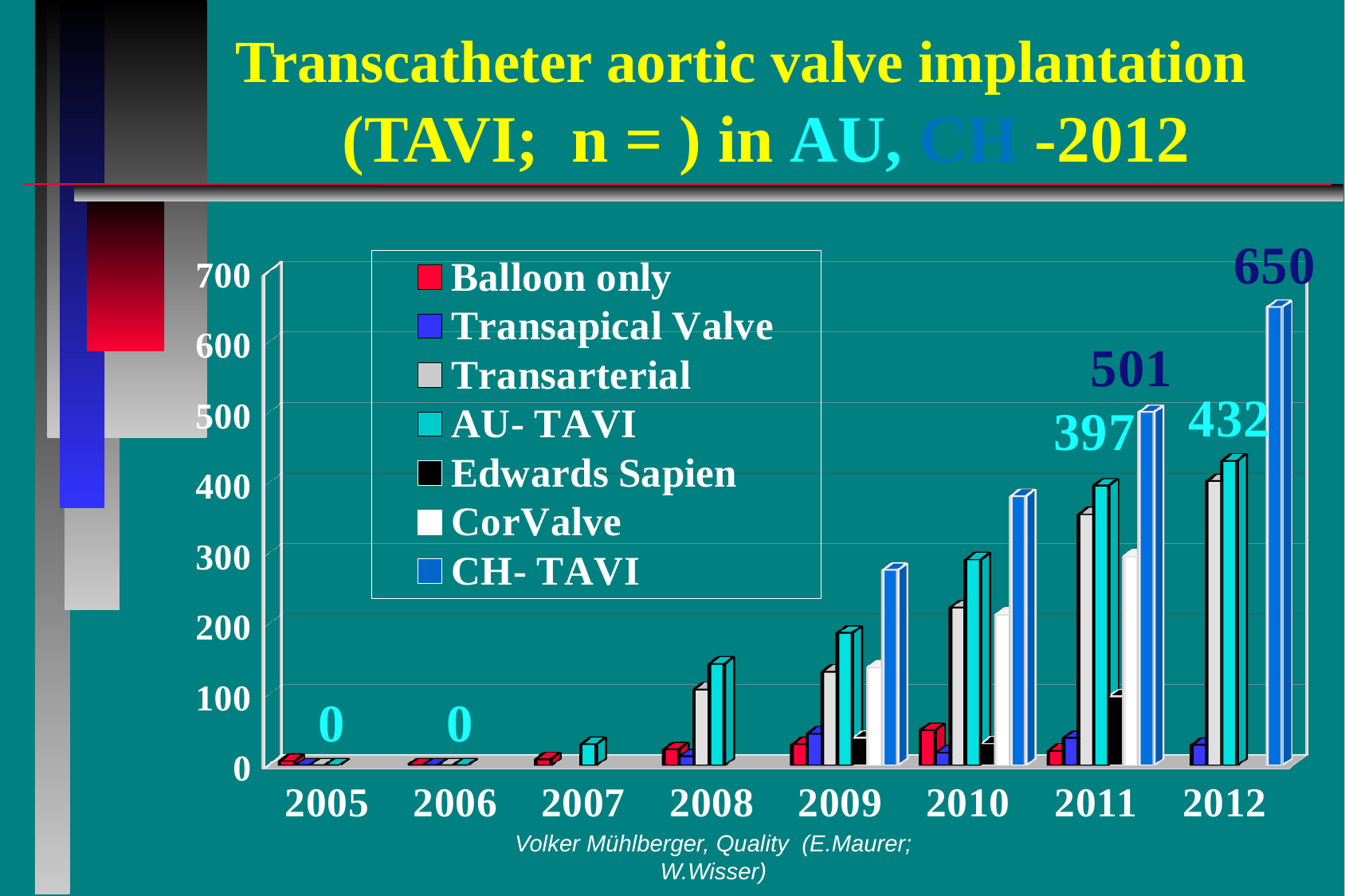
What is the AU-TAVI value for 2012? 432 Which is larger in 2012, the AU-TAVI value or the CH-TAVI value? CH-TAVI What is the CH-TAVI value for 2012? 650 What is the CH-TAVI value for 2011? 501 How many years are shown on the x axis? 8 What is the AU-TAVI value for 2011? 397 What kind of chart is shown on the slide? bar chart By how much did the CH-TAVI value increase from 2011 to 2012? 149 Is the CH-TAVI value for 2010 greater or less than 300? greater What is the AU-TAVI value labelled for 2005? 0 Do the CH-TAVI values rise or fall from 2009 to 2012? rise How many series does the legend list? 7